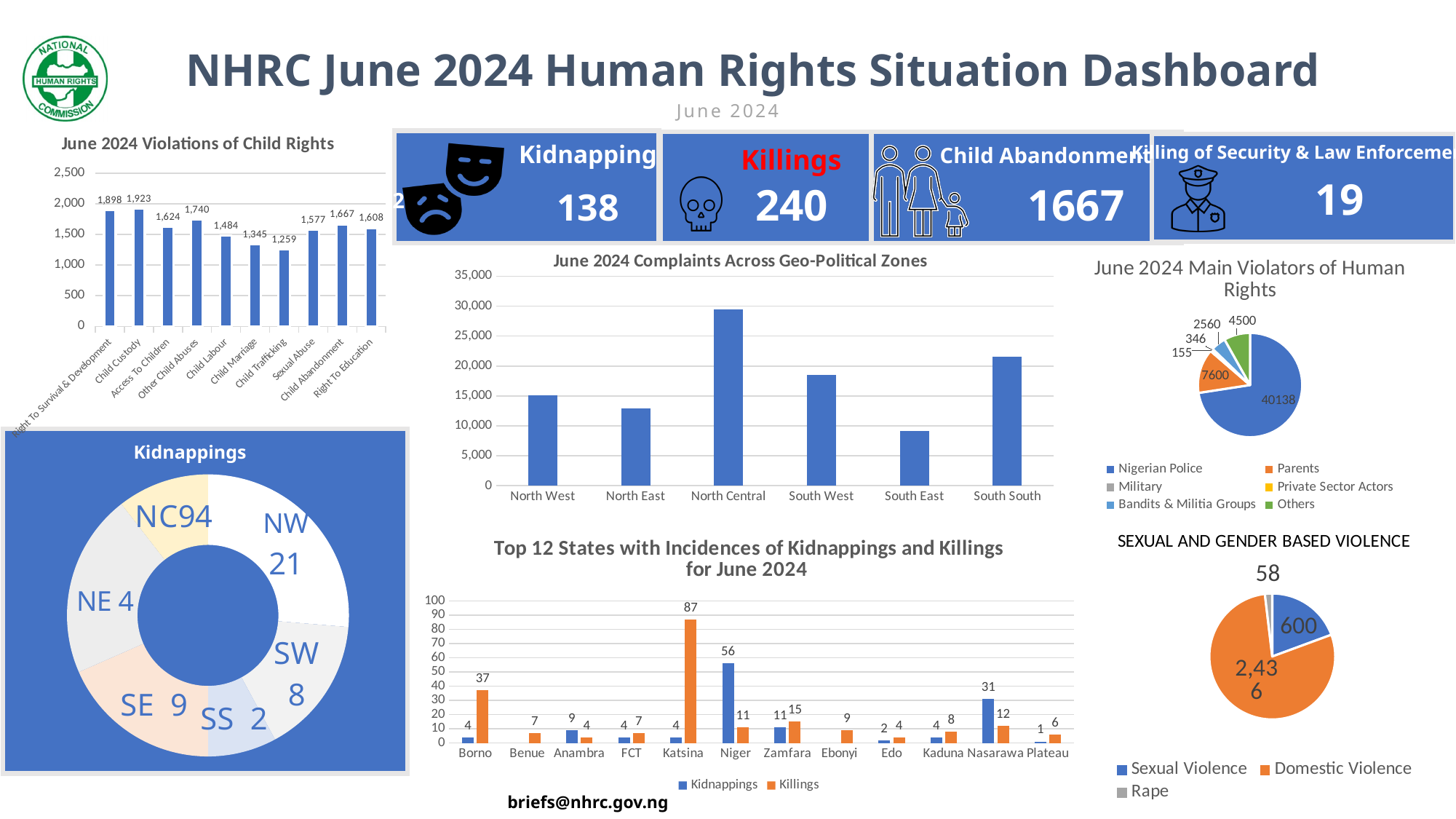
How many entries does the legend of the 'June 2024 Main Violators of Human Rights' pie chart list? 6 In the 'June 2024 Violations of Child Rights' chart, which category has the highest value? Child Custody In the 'June 2024 Main Violators of Human Rights' pie chart, what is the value for Parents? 7600 In the 'June 2024 Complaints Across Geo-Political Zones' chart, which zone has the lowest number of complaints? South East In the 'June 2024 Violations of Child Rights' chart, what is the difference between Child Custody and Right To Survival & Development? 25 In the 'SEXUAL AND GENDER BASED VIOLENCE' pie chart, what is the value for Rape? 58 In the 'June 2024 Violations of Child Rights' chart, what is the value for Child Trafficking? 1,259 In the 'Kidnappings' donut chart, what is the value for NC? 94 How many zones are shown in the 'June 2024 Complaints Across Geo-Political Zones' chart? 6 In the 'Top 12 States with Incidences of Kidnappings and Killings for June 2024' chart, what is the Killings value for Katsina? 87 In the 'Top 12 States with Incidences of Kidnappings and Killings for June 2024' chart, which is larger for Niger: Kidnappings or Killings? Kidnappings In the 'June 2024 Complaints Across Geo-Political Zones' chart, is the value for North Central greater or less than 25,000? greater